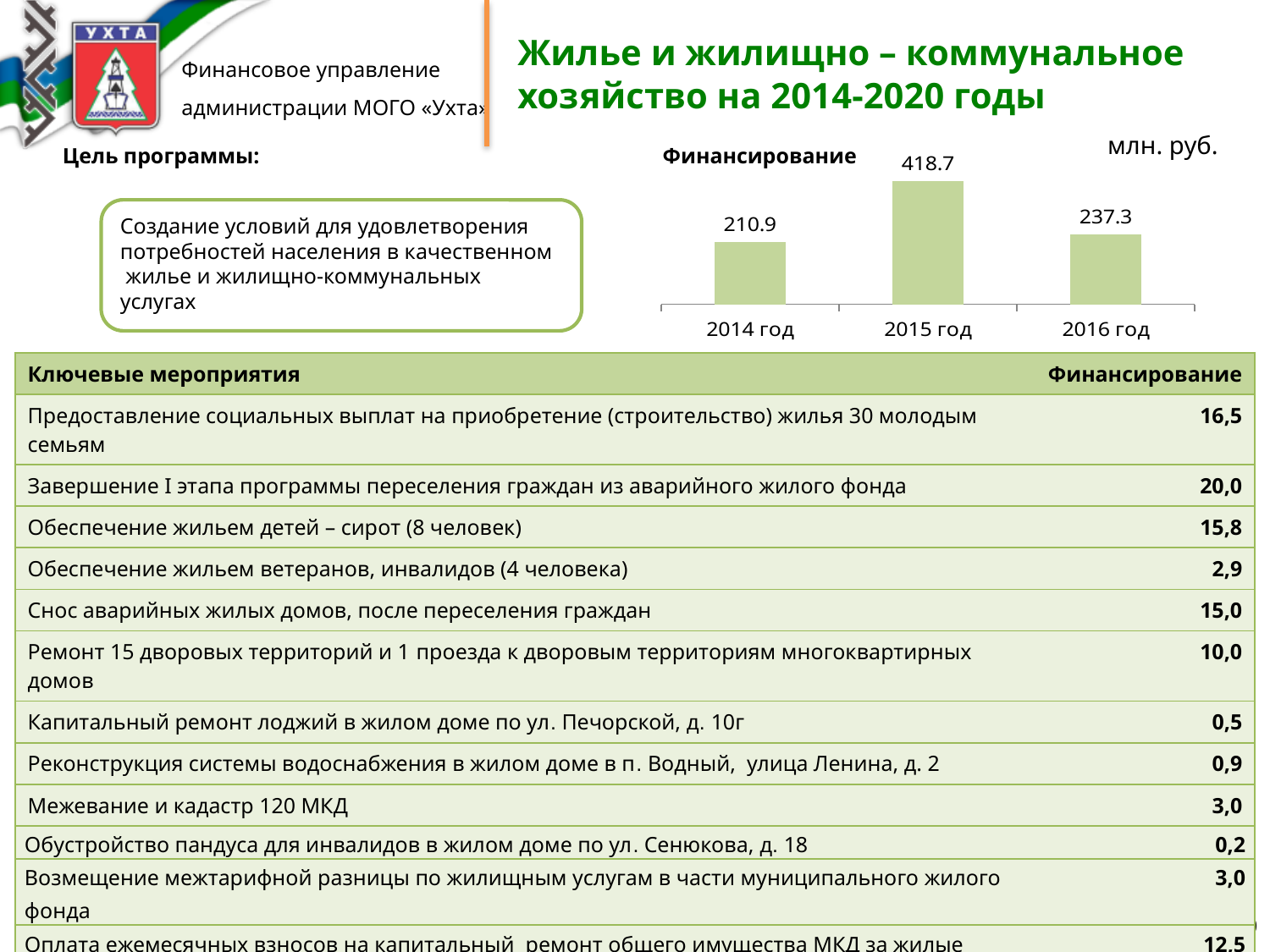
What is the difference between the values for 2015 год and 2014 год in the Финансирование chart? 207.8 What is the value for 2014 год in the Финансирование chart? 210.9 Which year has the lowest value in the Финансирование chart? 2014 год Which year has the highest value in the Финансирование chart? 2015 год What kind of chart is the Финансирование chart? bar chart What is the value for 2016 год in the Финансирование chart? 237.3 How many years are shown in the Финансирование chart? 3 In what units are the values in the Финансирование chart given? млн. руб. What is the difference between the values for 2016 год and 2014 год in the Финансирование chart? 26.4 What is the value for 2015 год in the Финансирование chart? 418.7 Which is larger in the Финансирование chart, the value for 2016 год or the value for 2014 год? 2016 год What is the title of the chart on the slide? Финансирование